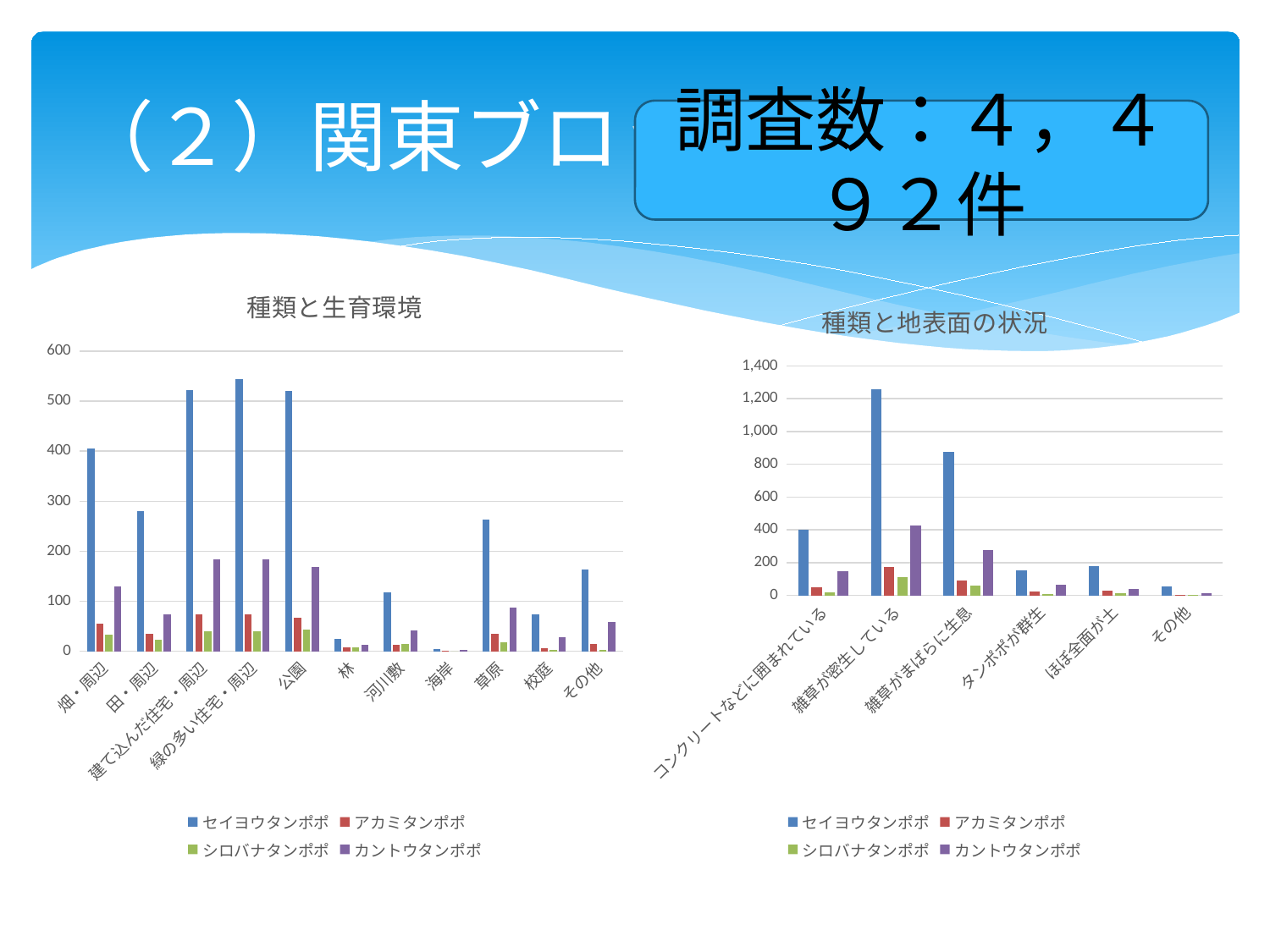
How many categories are shown on the x axis of the chart titled 種類と生育環境? 11 In the chart titled 種類と生育環境, which category has the lowest value for セイヨウタンポポ? 海岸 In the chart titled 種類と生育環境, which is larger for カントウタンポポ: 公園 or 畑・周辺? 公園 What kind of chart is the chart titled 種類と生育環境? bar chart How many categories are shown on the x axis of the chart titled 種類と地表面の状況? 6 In the chart titled 種類と地表面の状況, is the value for セイヨウタンポポ at 雑草がまばらに生息 greater or less than 800? greater What colour represents カントウタンポポ in the legend of the chart titled 種類と地表面の状況? purple In the chart titled 種類と生育環境, is the value for セイヨウタンポポ at 田・周辺 greater or less than 300? less In the chart titled 種類と地表面の状況, is the value for セイヨウタンポポ at 雑草が密生している greater or less than 1,200? greater How many series does the legend of the chart titled 種類と地表面の状況 list? 4 In the chart titled 種類と地表面の状況, which category has the highest value for セイヨウタンポポ? 雑草が密生している